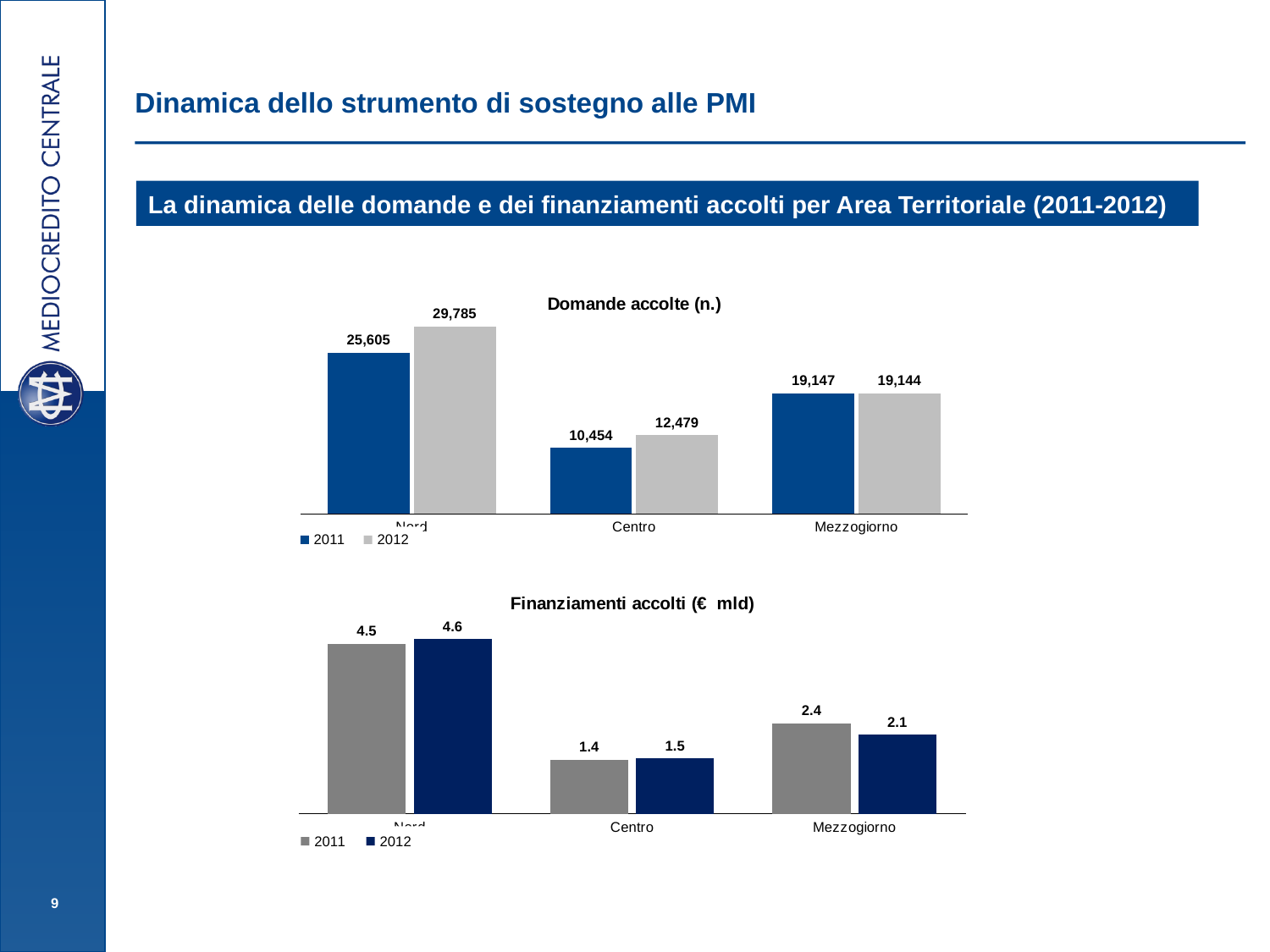
How many series does the legend of the 'Domande accolte (n.)' chart list? 2 In the 'Finanziamenti accolti (€ mld)' chart, by how much did the value for Mezzogiorno fall from 2011 to 2012? 0.3 In the 'Finanziamenti accolti (€ mld)' chart, what is the value for Mezzogiorno in 2011? 2.4 In the 'Domande accolte (n.)' chart, what is the difference between the 2012 and 2011 values for Centro? 2,025 What are the two legend entries in the 'Finanziamenti accolti (€ mld)' chart? 2011 and 2012 In the 'Finanziamenti accolti (€ mld)' chart, which category has the lowest value in 2012? Centro In the 'Domande accolte (n.)' chart, which category has the lowest value in 2011? Centro In the 'Domande accolte (n.)' chart, what is the value for Mezzogiorno in 2012? 19,144 What kind of chart is the 'Finanziamenti accolti (€ mld)' chart? bar chart In the 'Domande accolte (n.)' chart, what is the value for Centro in 2011? 10,454 In the 'Domande accolte (n.)' chart, is the 2011 value for Mezzogiorno larger or smaller than the 2012 value? larger In the 'Finanziamenti accolti (€ mld)' chart, what is the value for Centro in 2012? 1.5